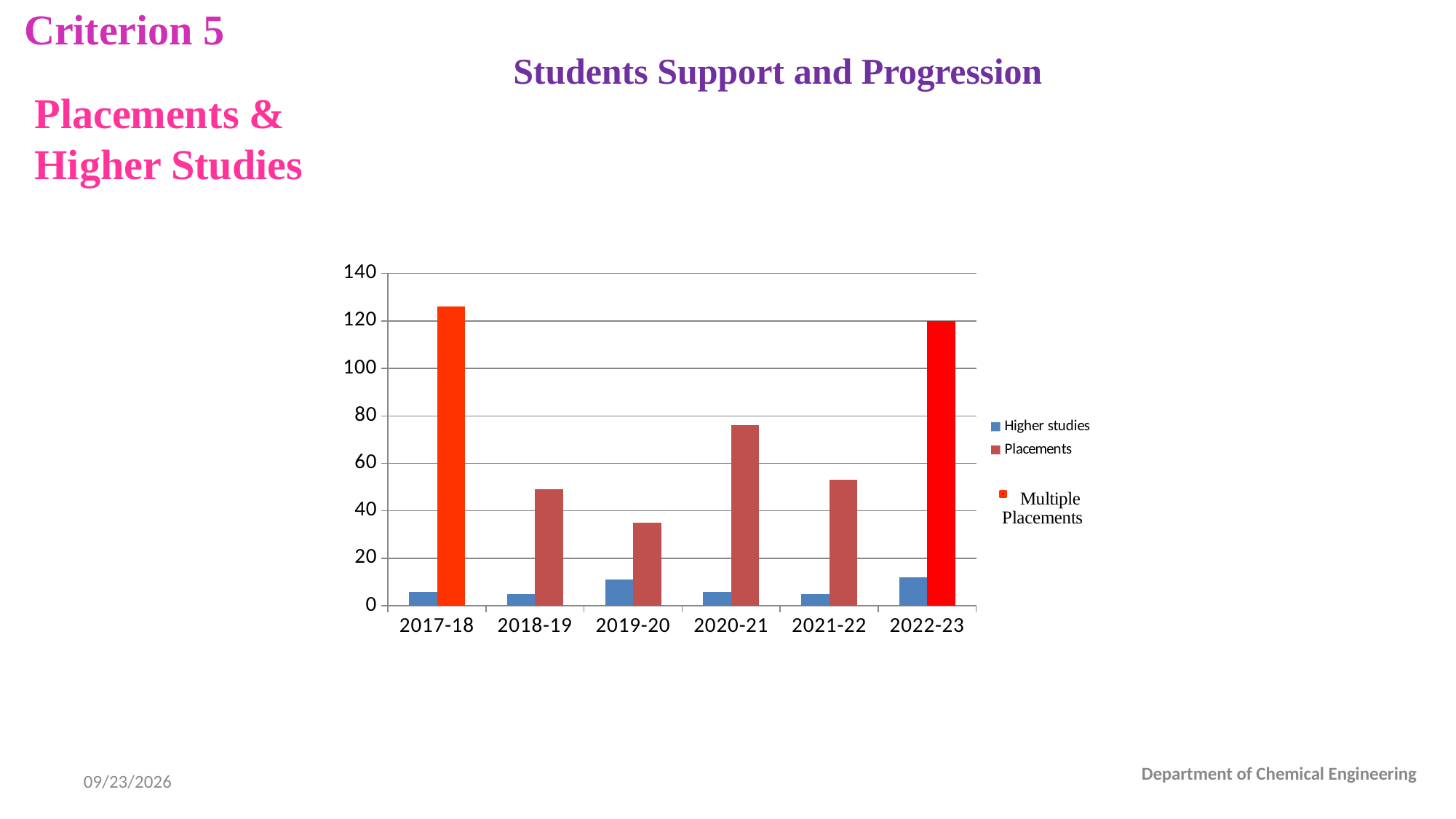
In 2019-20, which is larger, Higher studies or Placements? Placements How many academic years are shown on the x axis of the chart? 6 Which year has the lowest Placements value? 2019-20 Which years have their Placements bars highlighted in red as Multiple Placements? 2017-18 and 2022-23 Is the Placements value for 2017-18 greater or less than 100? greater Is the Placements value for 2019-20 greater or less than 40? less Is the Higher studies value for 2022-23 greater or less than 20? less Which year has the highest Placements value? 2017-18 Which is larger, the Placements value for 2020-21 or for 2021-22? 2020-21 What kind of chart is shown on the slide? bar chart